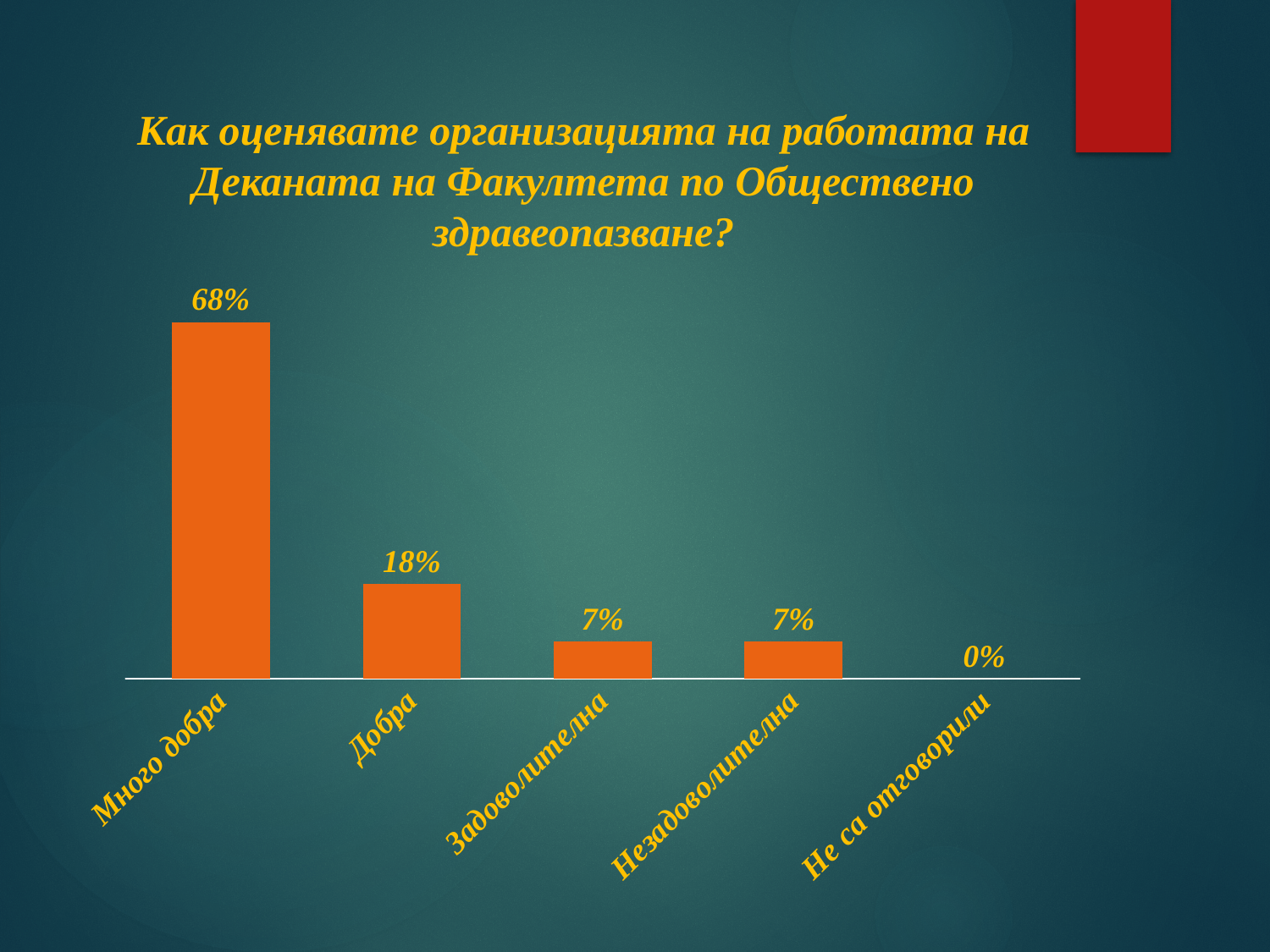
What is the value for "Много добра"? 68% What is the value for "Не са отговорили"? 0% Which category has the lowest value? Не са отговорили What is the difference between the values for "Много добра" and "Добра"? 50% What is the difference between the values for "Добра" and "Незадоволителна"? 11% What is the value for "Добра"? 18% What kind of chart is shown on the slide? Bar chart Which category has the highest value? Много добра How many categories are shown on the x axis? 5 Which is larger, the value for "Добра" or the value for "Задоволителна"? Добра Do the values rise or fall from left to right along the x axis? Fall What is the value for "Задоволителна"? 7%